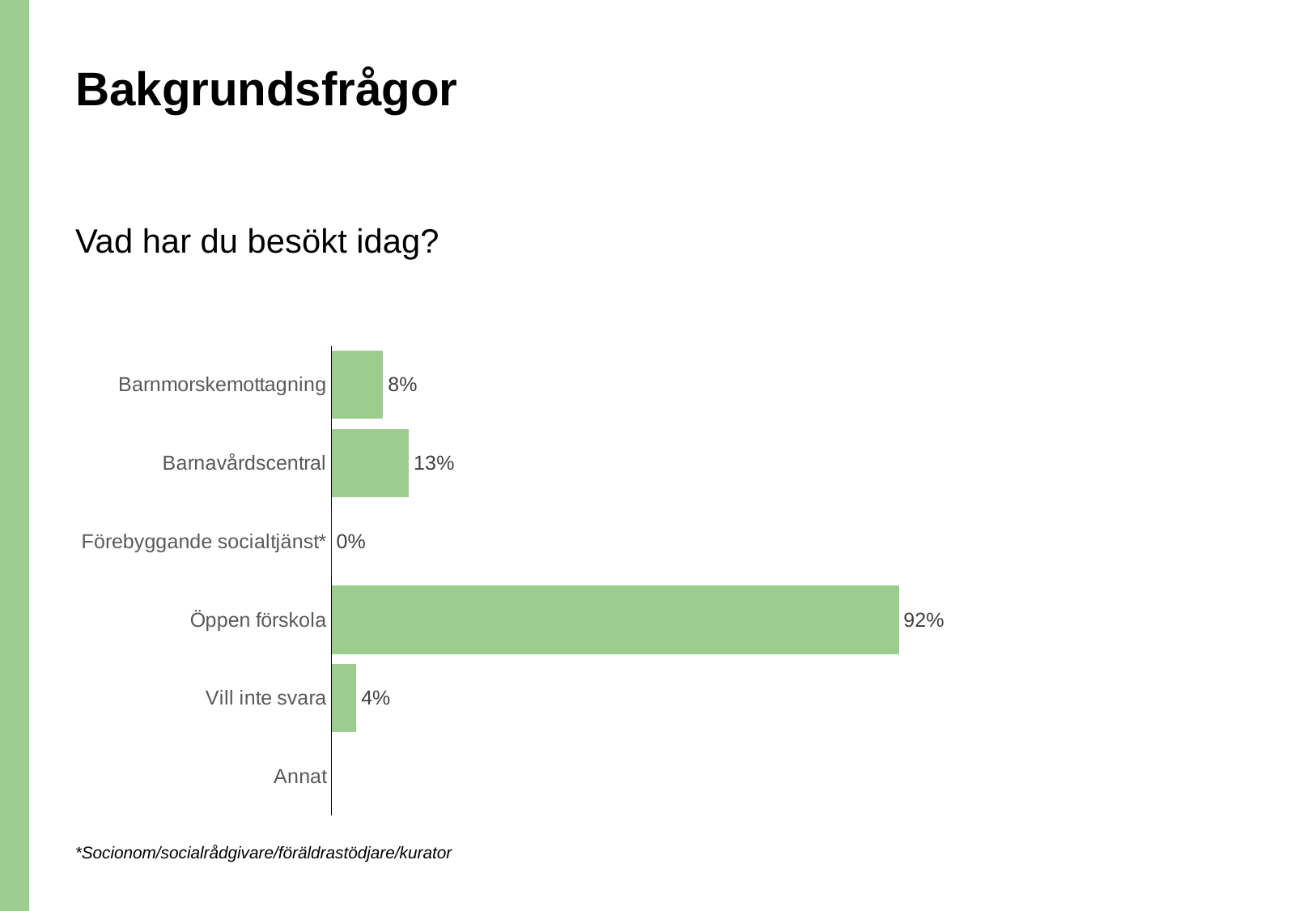
What is the difference between the values for Öppen förskola and Barnavårdscentral? 79 percentage points What question does the chart answer, according to the text above it? Vad har du besökt idag? What percentage is shown for Vill inte svara? 4% What is the difference between the values for Barnavårdscentral and Barnmorskemottagning? 5 percentage points How many categories are listed on the chart's axis? 6 Which is larger, the value for Barnmorskemottagning or the value for Vill inte svara? Barnmorskemottagning What type of chart is shown on the slide? Bar chart What value is shown for Förebyggande socialtjänst*? 0% Which category has the highest value in the chart? Öppen förskola What is the value shown for Barnavårdscentral? 13% What is the value shown for Barnmorskemottagning? 8% What percentage of respondents visited Öppen förskola? 92%